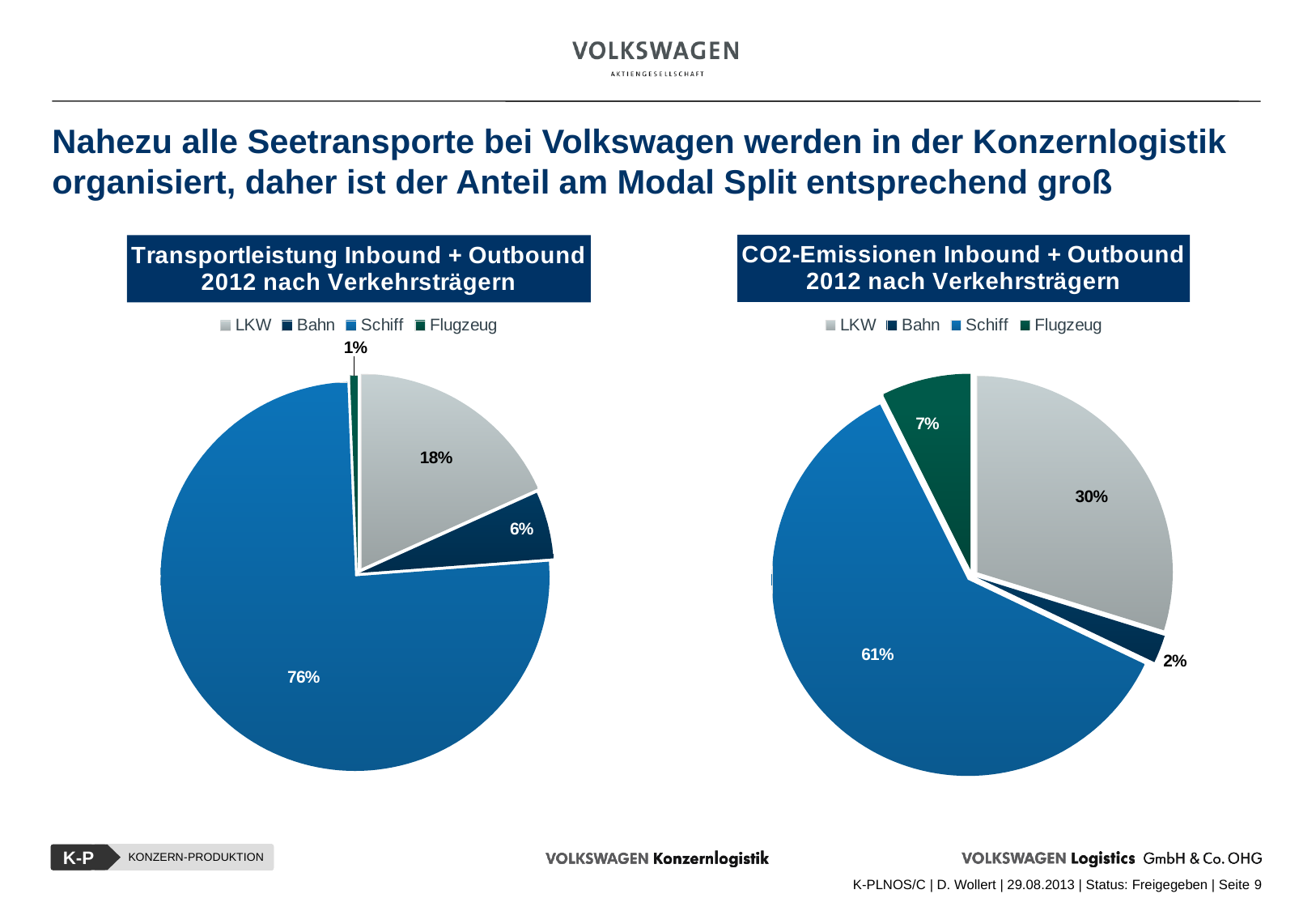
In the 'CO2-Emissionen Inbound + Outbound 2012 nach Verkehrsträgern' chart, which mode of transport has the smallest share? Bahn What is the difference between the LKW share in the 'CO2-Emissionen' chart and the LKW share in the 'Transportleistung' chart? 12 percentage points In the 'CO2-Emissionen Inbound + Outbound 2012 nach Verkehrsträgern' chart, what share does Flugzeug have? 7% How many slices does the 'Transportleistung Inbound + Outbound 2012 nach Verkehrsträgern' pie chart have? 4 In the 'Transportleistung Inbound + Outbound 2012 nach Verkehrsträgern' chart, which mode of transport has the largest share? Schiff In the 'CO2-Emissionen Inbound + Outbound 2012 nach Verkehrsträgern' chart, what share does LKW have? 30% In the 'Transportleistung Inbound + Outbound 2012 nach Verkehrsträgern' chart, what share does Bahn have? 6% In the 'Transportleistung Inbound + Outbound 2012 nach Verkehrsträgern' chart, which mode of transport has the smallest share? Flugzeug In the 'CO2-Emissionen Inbound + Outbound 2012 nach Verkehrsträgern' chart, which is larger: the share of Flugzeug or the share of Bahn? Flugzeug What type of chart is the 'CO2-Emissionen Inbound + Outbound 2012 nach Verkehrsträgern' chart? Pie chart In the 'Transportleistung Inbound + Outbound 2012 nach Verkehrsträgern' chart, what share does Schiff have? 76% How many entries does the legend of the 'CO2-Emissionen Inbound + Outbound 2012 nach Verkehrsträgern' chart list? 4